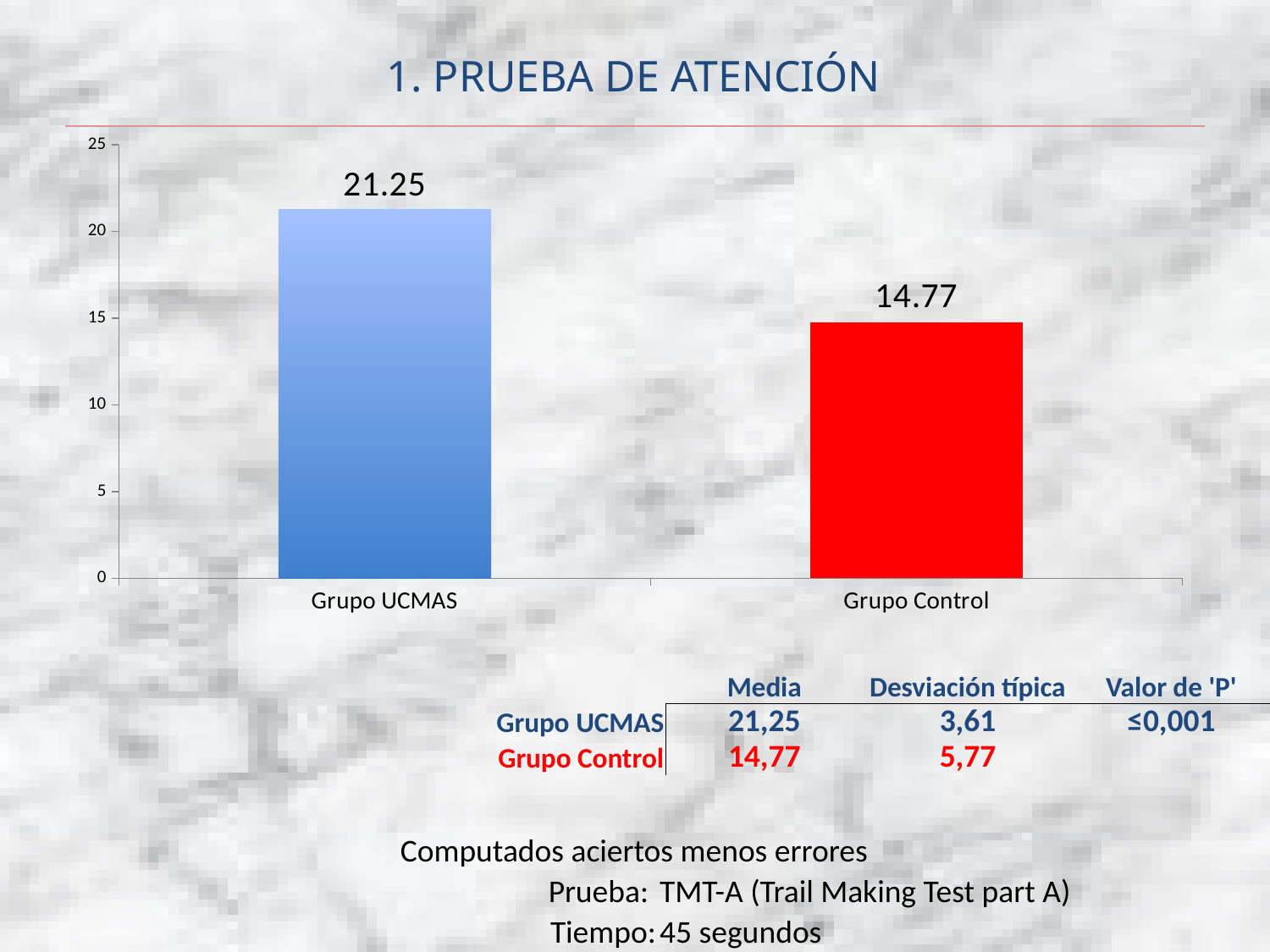
Which group has the highest value? Grupo UCMAS What is the maximum value shown on the y axis? 25 What colour is the bar for Grupo Control? red Is the value for Grupo UCMAS greater or less than 20? greater How many categories are shown on the x axis? 2 Is the value for Grupo Control greater or less than 15? less What kind of chart is shown on the slide? bar chart What is the value for Grupo UCMAS? 21.25 Which is larger, the value for Grupo UCMAS or Grupo Control? Grupo UCMAS What is the difference between the values for Grupo UCMAS and Grupo Control? 6.48 Which group has the lowest value? Grupo Control What is the value for Grupo Control? 14.77